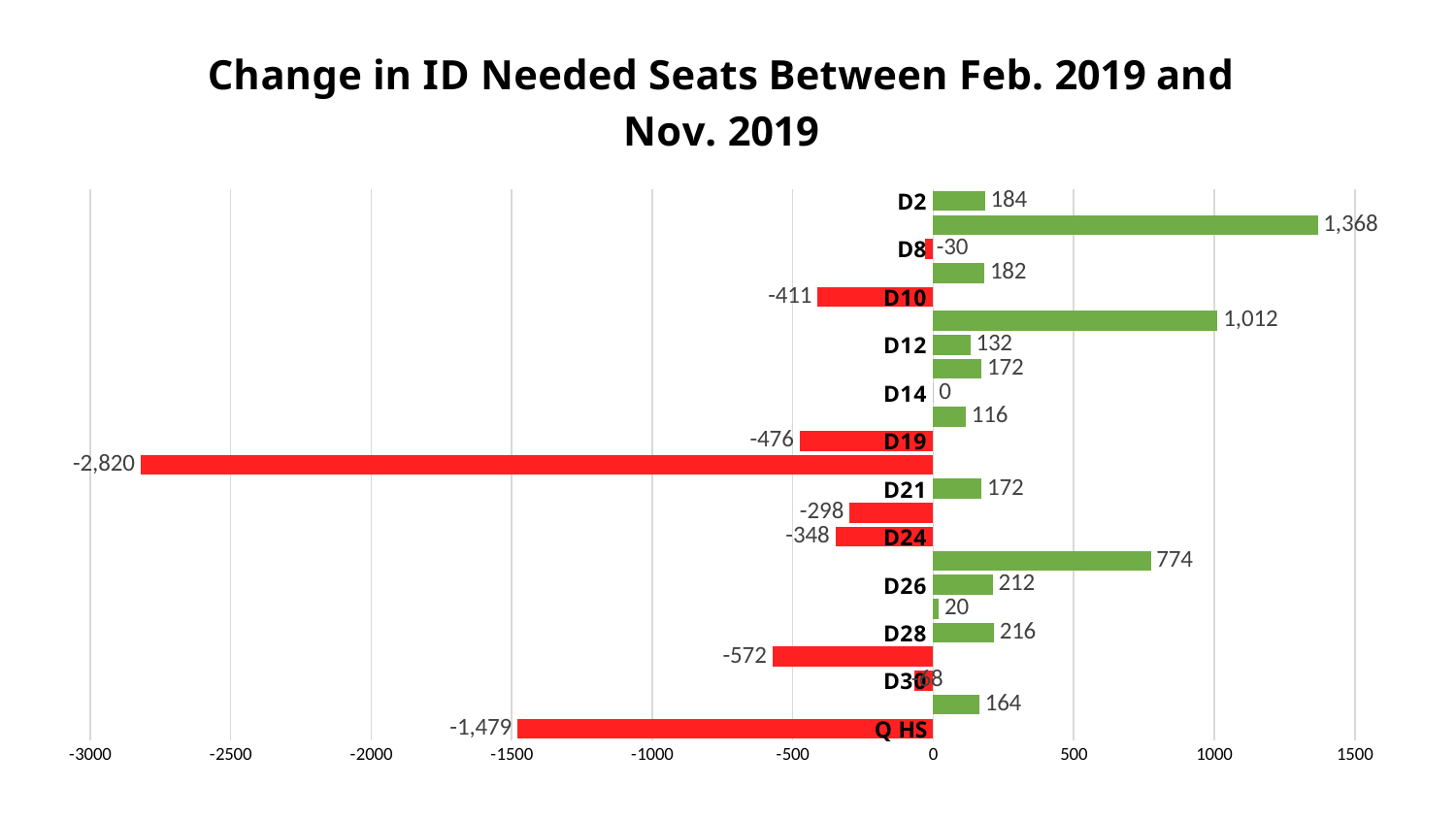
Which has the larger decrease, D10 or D24? D10 What is the value for D14? 0 What is the value for Q HS? -1,479 What kind of chart is shown on the slide? Bar chart What is the difference between the values for D28 and D26? 4 What is the value for D19? -476 What colour are the bars with negative values? Red What is the value for D12? 132 What is the lowest (most negative) value shown on the chart? -2,820 Is the value for D10 greater or less than -500? greater What is the value for D2? 184 What is the largest value shown on the chart? 1,368